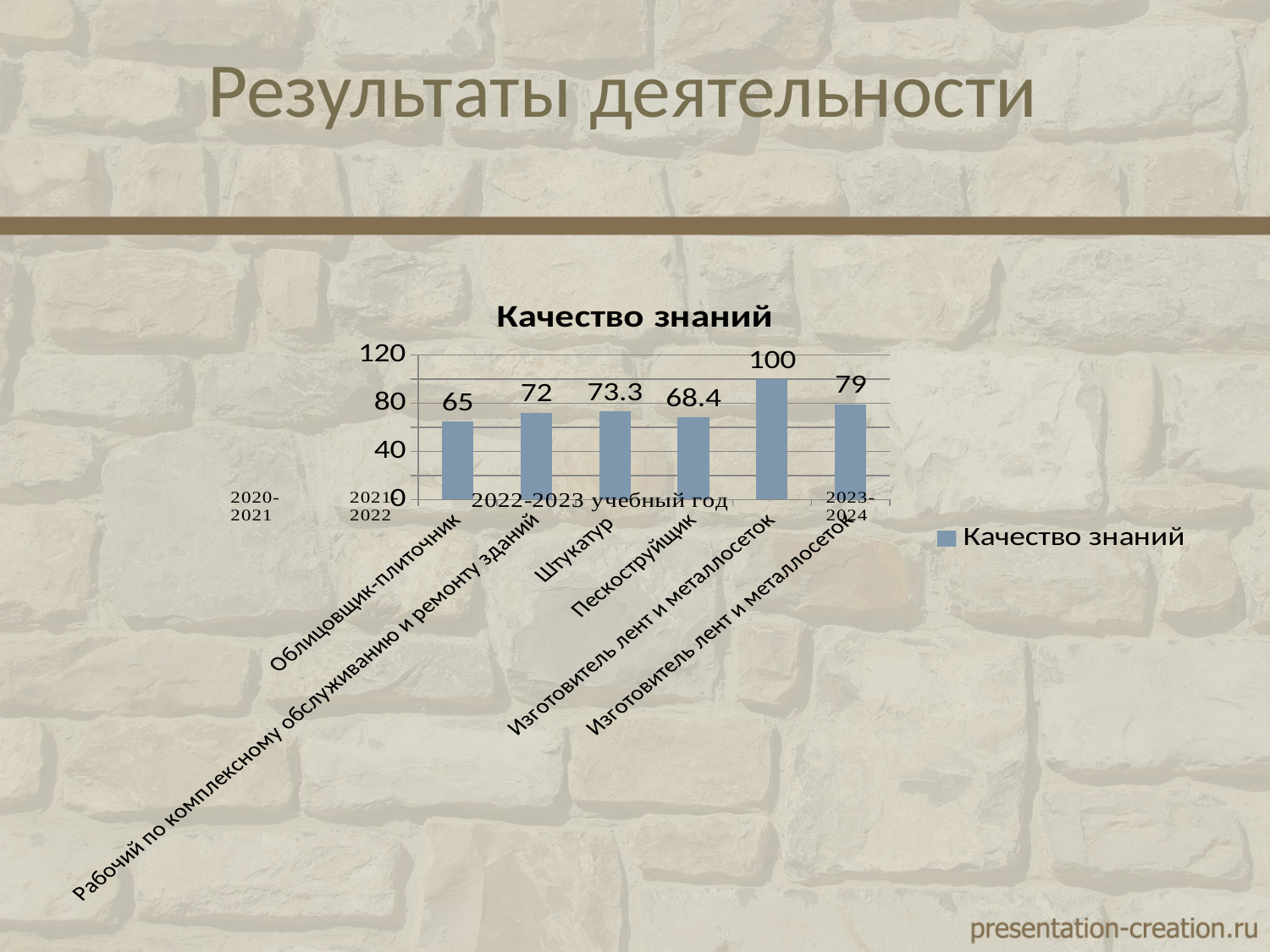
How many bars are plotted in the chart? 6 What is the value for Облицовщик-плиточник in the Качество знаний chart? 65 Is the value for Пескоструйщик greater or less than 80? less What is the highest value shown in the chart? 100 What is the value for Пескоструйщик? 68.4 Which category has the lowest value? Облицовщик-плиточник What kind of chart is shown on the slide? bar chart What is the value for Рабочий по комплексному обслуживанию и ремонту зданий? 72 Which is larger, the value for Штукатур or the value for Пескоструйщик? Штукатур What is the value for Штукатур? 73.3 What is the difference between the values for Штукатур and Облицовщик-плиточник? 8.3 How many series does the legend list? 1